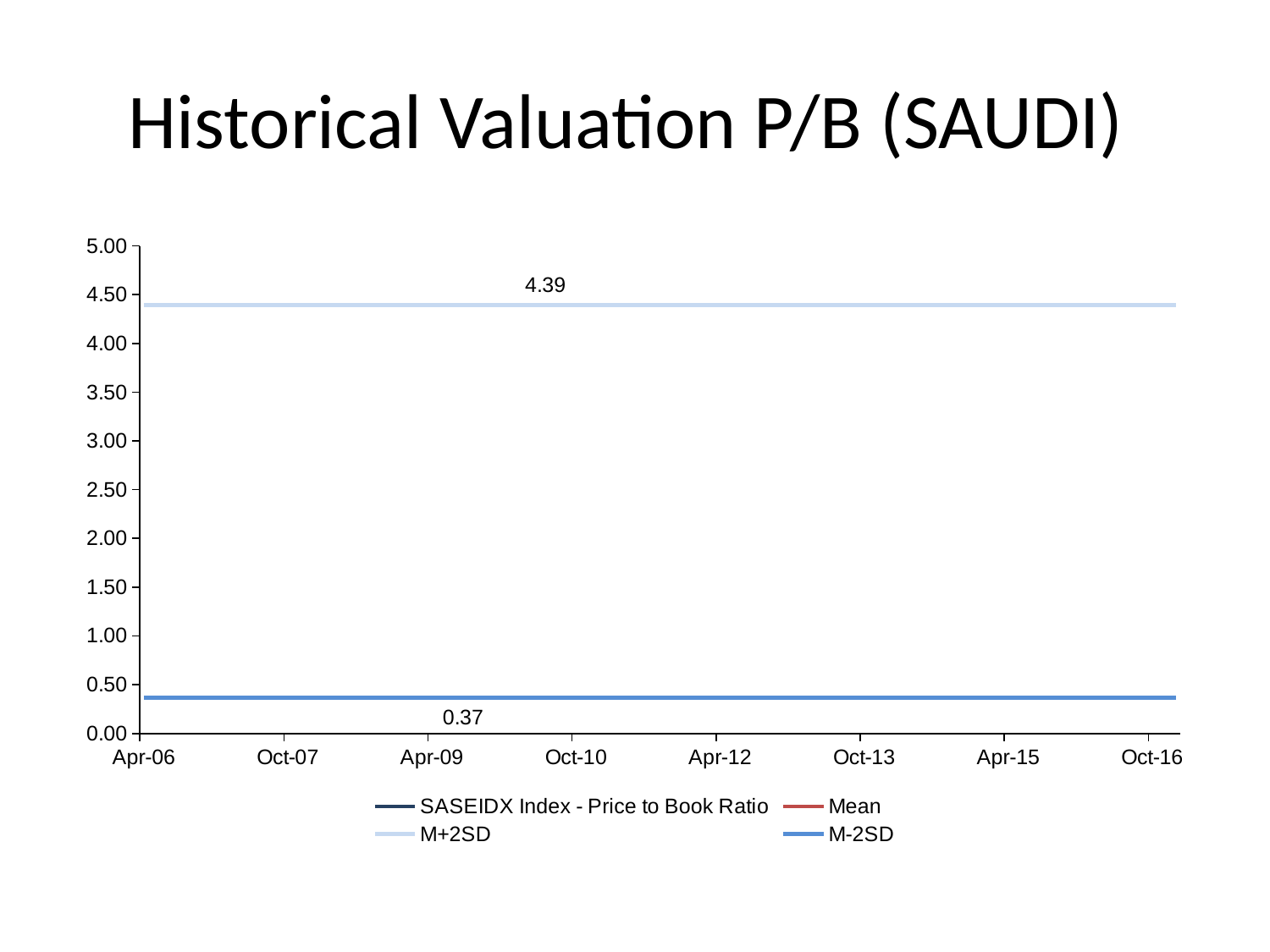
Does the M+2SD line rise, fall, or stay flat from Apr-06 to Oct-16? Stays flat What is the difference between the M+2SD value (4.39) and the M-2SD value (0.37)? 4.02 How many date labels are shown on the x axis? 8 What is the first date label on the x axis? Apr-06 Is the value of the M-2SD line greater or less than 0.50? less How many series does the legend list? 4 Which line is higher on the chart, M+2SD or M-2SD? M+2SD What value is labelled on the M+2SD line? 4.39 What kind of chart is shown on the slide? Line chart What value is labelled on the M-2SD line? 0.37 What is the title of the slide? Historical Valuation P/B (SAUDI) Is the value of the M+2SD line greater or less than 4.00? greater